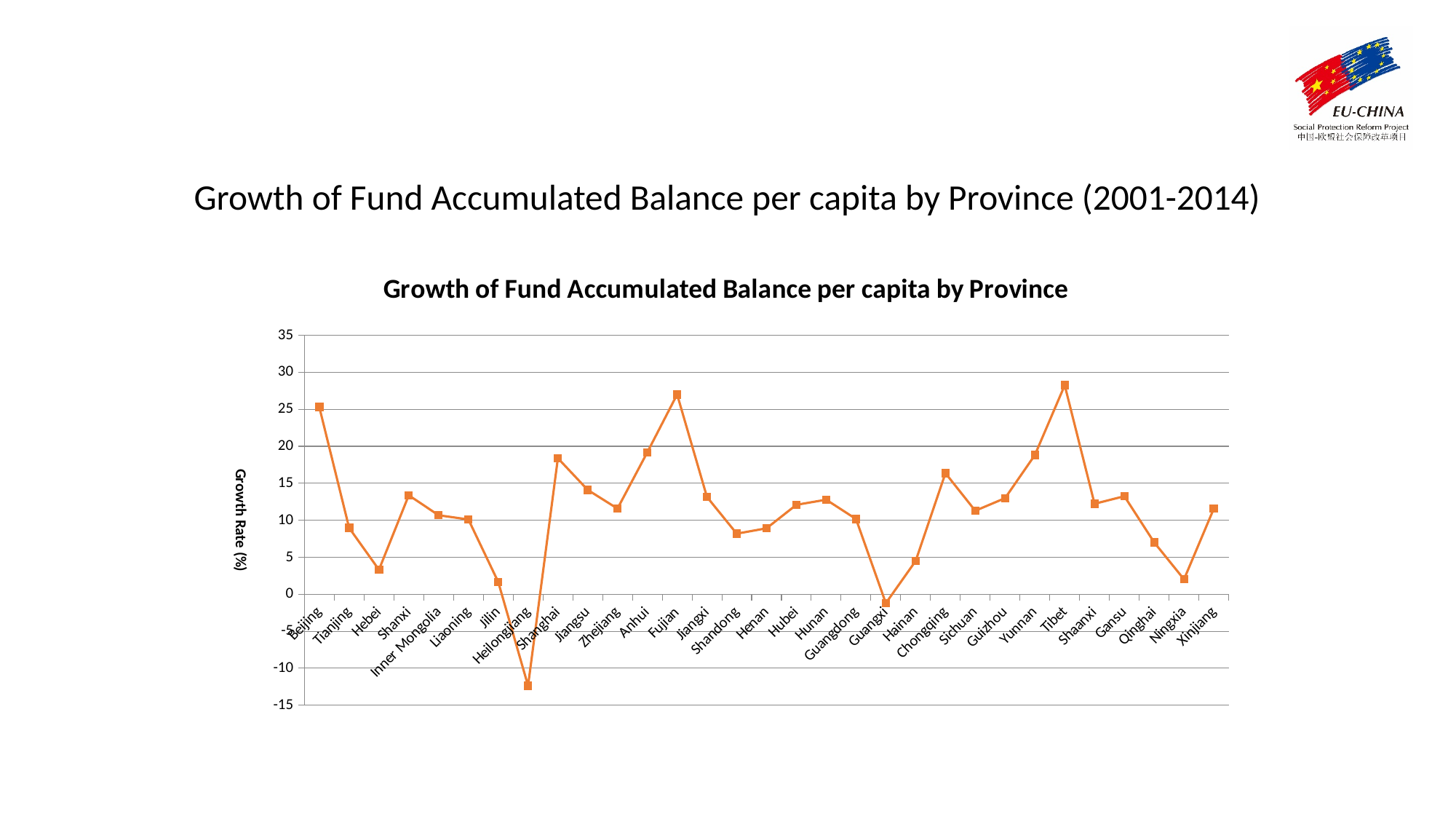
Which has the higher growth rate, Beijing or Tianjing? Beijing Which province has the highest growth rate? Tibet Is the value for Heilongjiang greater or less than -10? less How many provinces are plotted along the x axis? 31 What kind of chart is shown on the slide? line chart Is the value for Beijing greater or less than 20? greater What is the label of the vertical axis? Growth Rate (%) Is the value for Guangxi greater or less than 0? less Which province has the lowest growth rate? Heilongjiang Which has the higher growth rate, Shanghai or Hebei? Shanghai